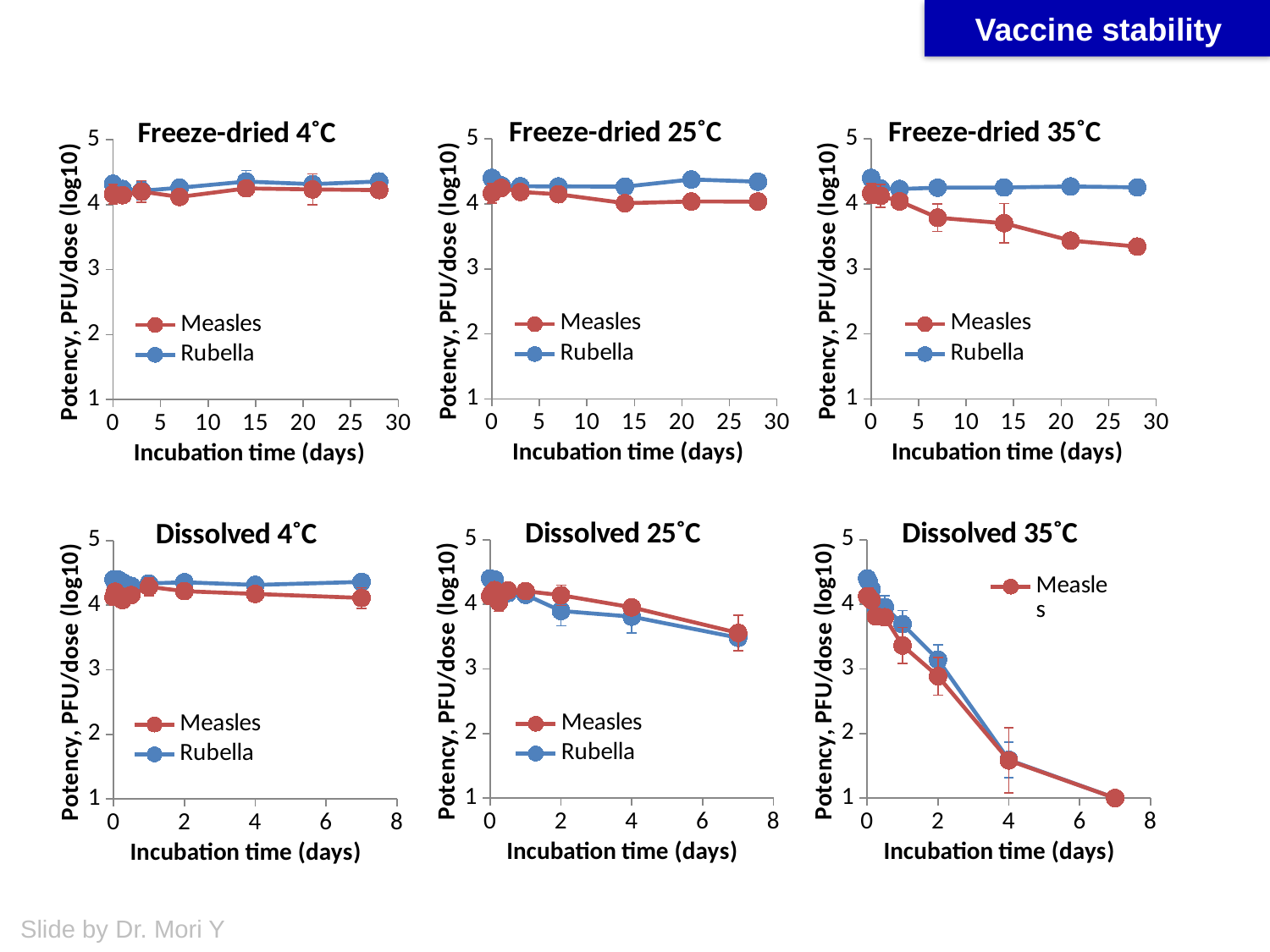
In the 'Dissolved 35˚C' chart, is the Measles value at 4 days greater or less than 3? less In the 'Freeze-dried 35˚C' chart, does the Measles series rise or fall as incubation time increases? fall What is the y-axis label on the 'Dissolved 4˚C' chart? Potency, PFU/dose (log10) In the 'Freeze-dried 35˚C' chart, at 28 days, which series has the higher potency, Measles or Rubella? Rubella In the 'Freeze-dried 25˚C' chart, at 21 days, which series has the higher potency, Measles or Rubella? Rubella In the 'Freeze-dried 4˚C' chart, is the Rubella value at 14 days greater or less than 4? greater In the 'Freeze-dried 35˚C' chart, is the Measles value at 28 days greater or less than 4? less What kind of chart is the 'Freeze-dried 4˚C' chart? line chart How many charts are shown on the slide? 6 In the 'Dissolved 35˚C' chart, do the plotted values rise or fall along the x axis? fall How many series does the legend of the 'Freeze-dried 25˚C' chart list? 2